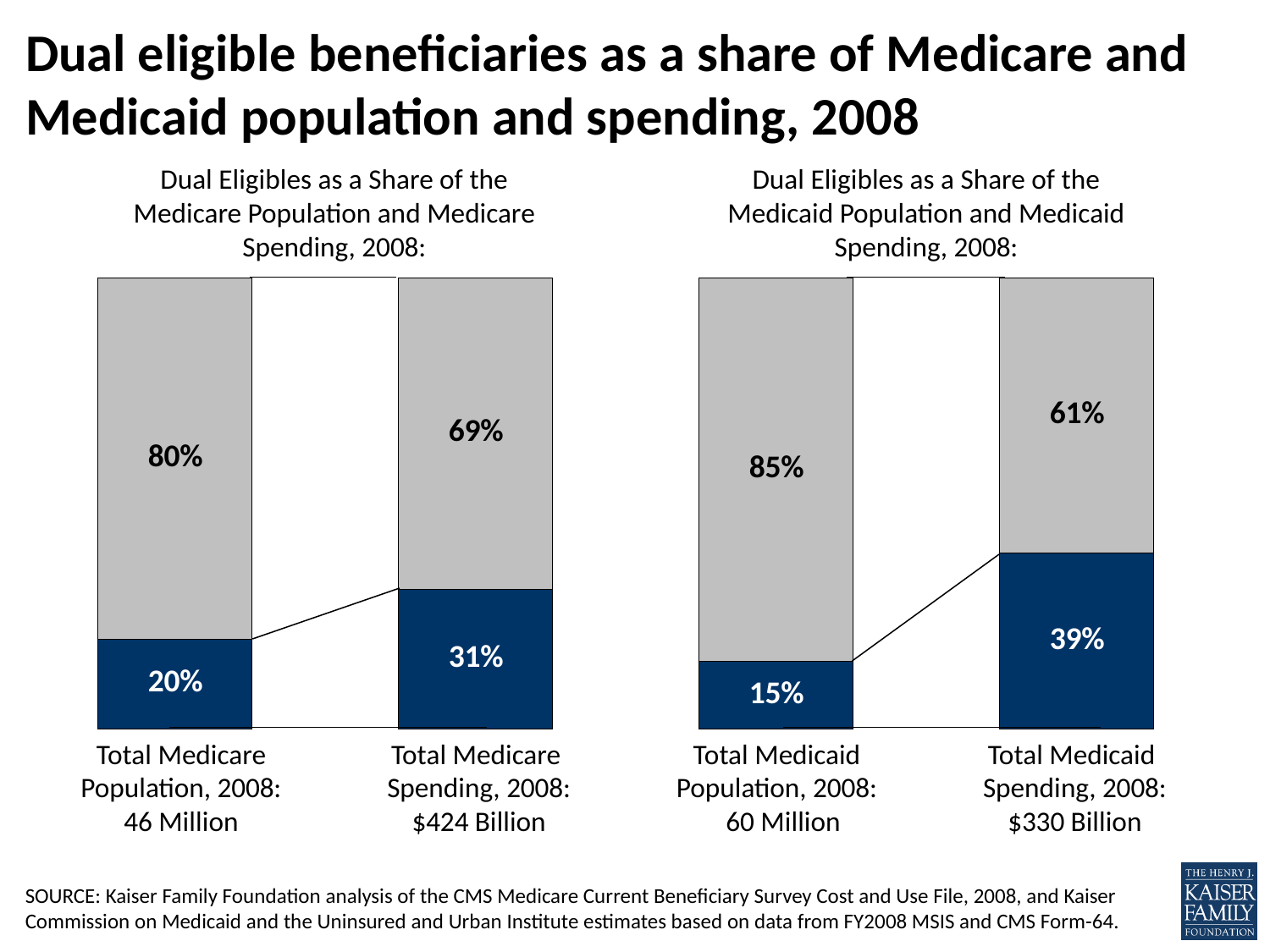
In the left chart (Medicare), what share of the total Medicare population is shown in the dark blue segment for Total Medicare Population, 2008? 20% In the right chart (Medicaid), what share of Total Medicaid Spending, 2008 is shown in the dark blue segment? 39% In the left chart (Medicare), what is the difference between the dark blue share of spending (31%) and the dark blue share of population (20%)? 11 percentage points In the left chart (Medicare), what share of Total Medicare Spending, 2008 is shown in the dark blue segment? 31% What type of chart is used on this slide? Stacked bar chart In the right chart (Medicaid), what is the difference between the dark blue share of spending (39%) and the dark blue share of population (15%)? 24 percentage points In the left chart (Medicare), what is the grey segment value for Total Medicare Spending, 2008? 69% In the right chart (Medicaid), what share of Total Medicaid Population, 2008 is shown in the dark blue segment? 15% In the right chart (Medicaid), which bar has the larger dark blue segment: Total Medicaid Population, 2008 or Total Medicaid Spending, 2008? Total Medicaid Spending, 2008 What total Medicare spending amount is given in the x-axis label of the left chart for 2008? $424 Billion How many bars are shown in the left chart (Medicare)? 2 In the right chart (Medicaid), what is the grey segment value for Total Medicaid Population, 2008? 85%